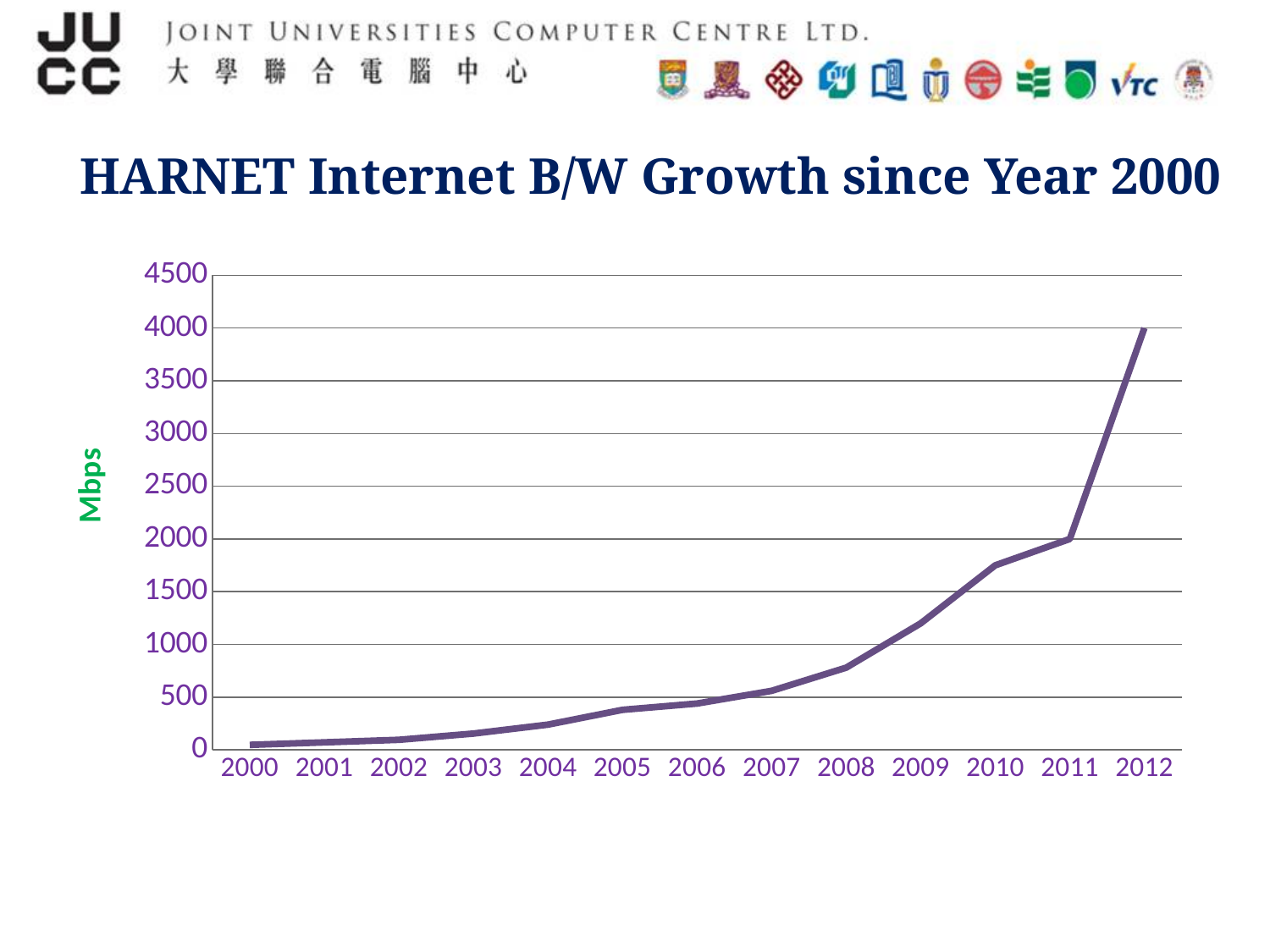
Which year has the highest bandwidth value? 2012 Which year has the larger value, 2008 or 2010? 2010 What is the bandwidth value for 2012 in Mbps? 4000 What kind of chart is shown on the slide? line chart Do the values rise or fall from 2000 to 2012? rise How many years are plotted along the x axis? 13 What is the title of the chart? HARNET Internet B/W Growth since Year 2000 Is the value for 2005 greater or less than 500? less Is the value for 2010 greater or less than 1500? greater Which year has the lowest bandwidth value? 2000 What unit is shown on the y-axis label? Mbps Is the value for 2008 greater or less than 1000? less